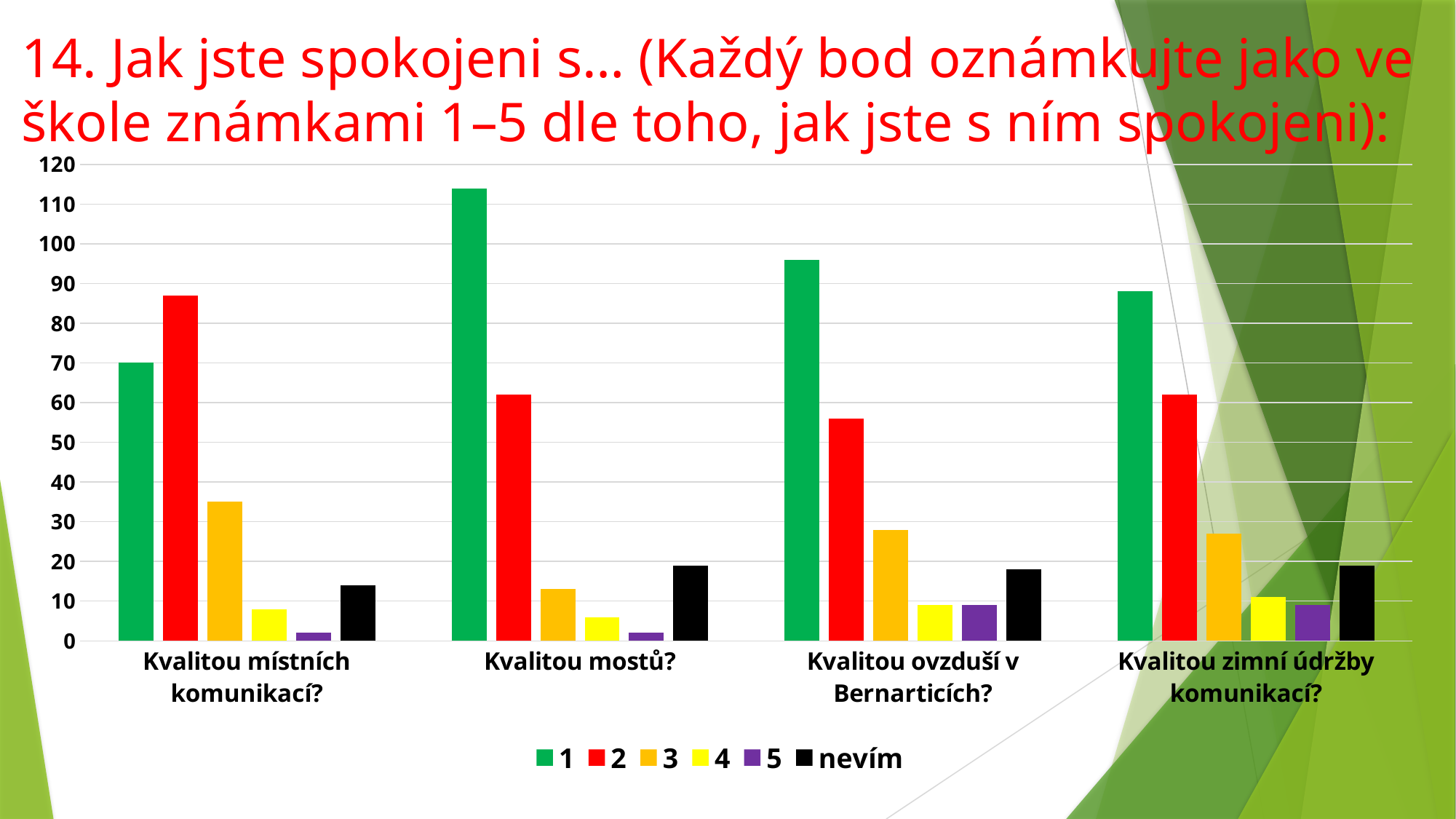
Which category has the lowest bar for series 3? Kvalitou mostů? Is the value for series 2 in the category Kvalitou ovzduší v Bernarticích? greater or less than 60? less Which is larger in the category Kvalitou místních komunikací?: the bar for series 1 or the bar for series 2? 2 Is the value for series 3 in the category Kvalitou místních komunikací? greater or less than 30? greater Is the value for series 1 in the category Kvalitou mostů? greater or less than 110? greater What kind of chart is shown on the slide? bar chart Which category has the highest bar for series 1? Kvalitou mostů? How many series does the legend list? 6 Which is larger in the category Kvalitou ovzduší v Bernarticích?: the bar for series 1 or the bar for series 2? 1 Which category has the highest bar for series 2? Kvalitou místních komunikací? What colour are the bars for the series nevím? black How many categories are shown on the x axis? 4